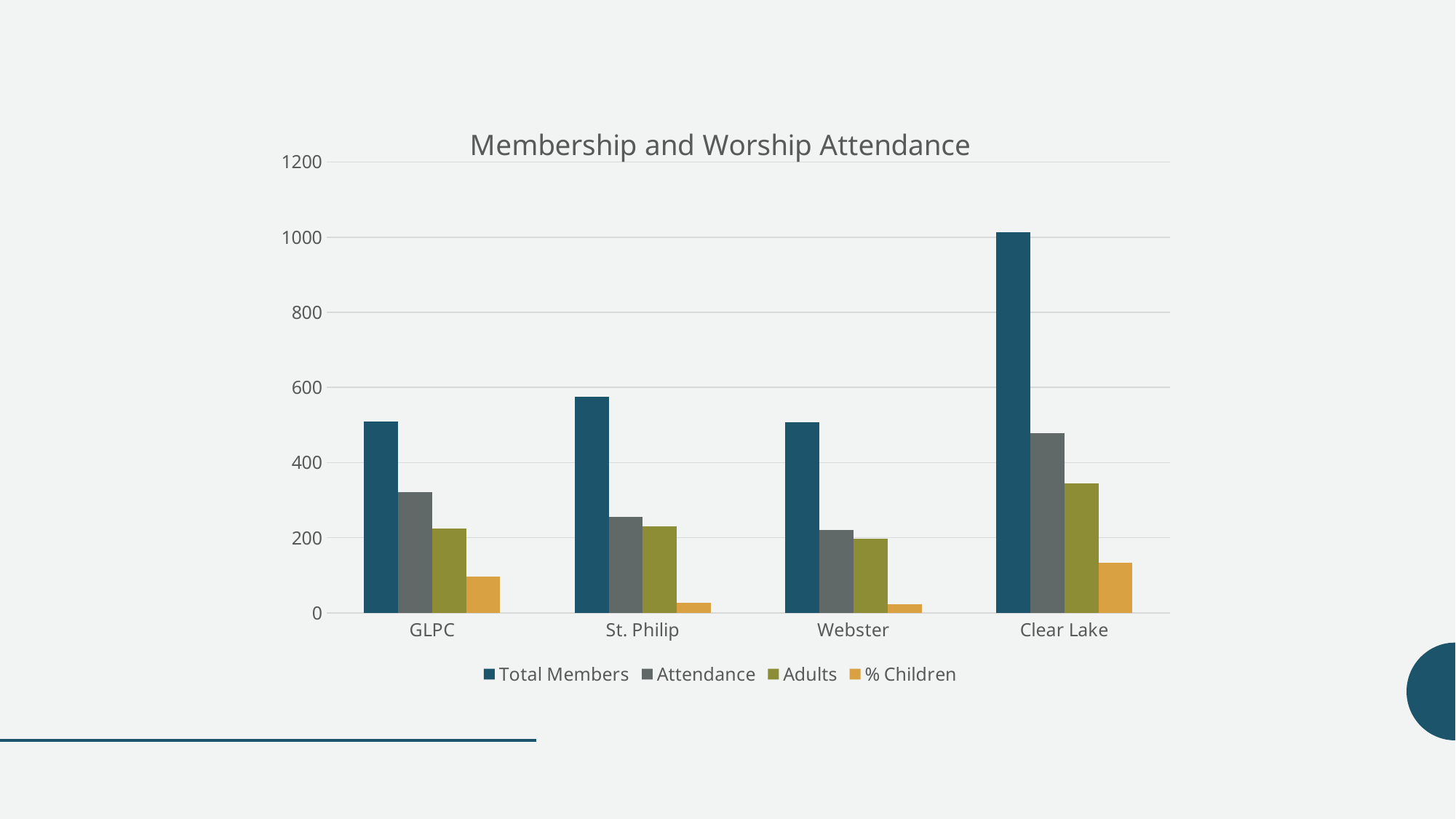
How many categories are shown on the x axis of the chart? 4 Which category has the lowest Attendance value? Webster What kind of chart is shown on the slide? bar chart Is the Total Members value for GLPC greater or less than 600? less What is the title of the chart? Membership and Worship Attendance How many series does the legend list? 4 Which is larger, the Attendance value for GLPC or for St. Philip? GLPC Is the Total Members value for Clear Lake greater or less than 800? greater Is the Attendance value for Clear Lake greater or less than 400? greater Which category has the highest % Children value? Clear Lake Which is larger, the Adults value for Clear Lake or for GLPC? Clear Lake Which category has the highest Total Members value? Clear Lake